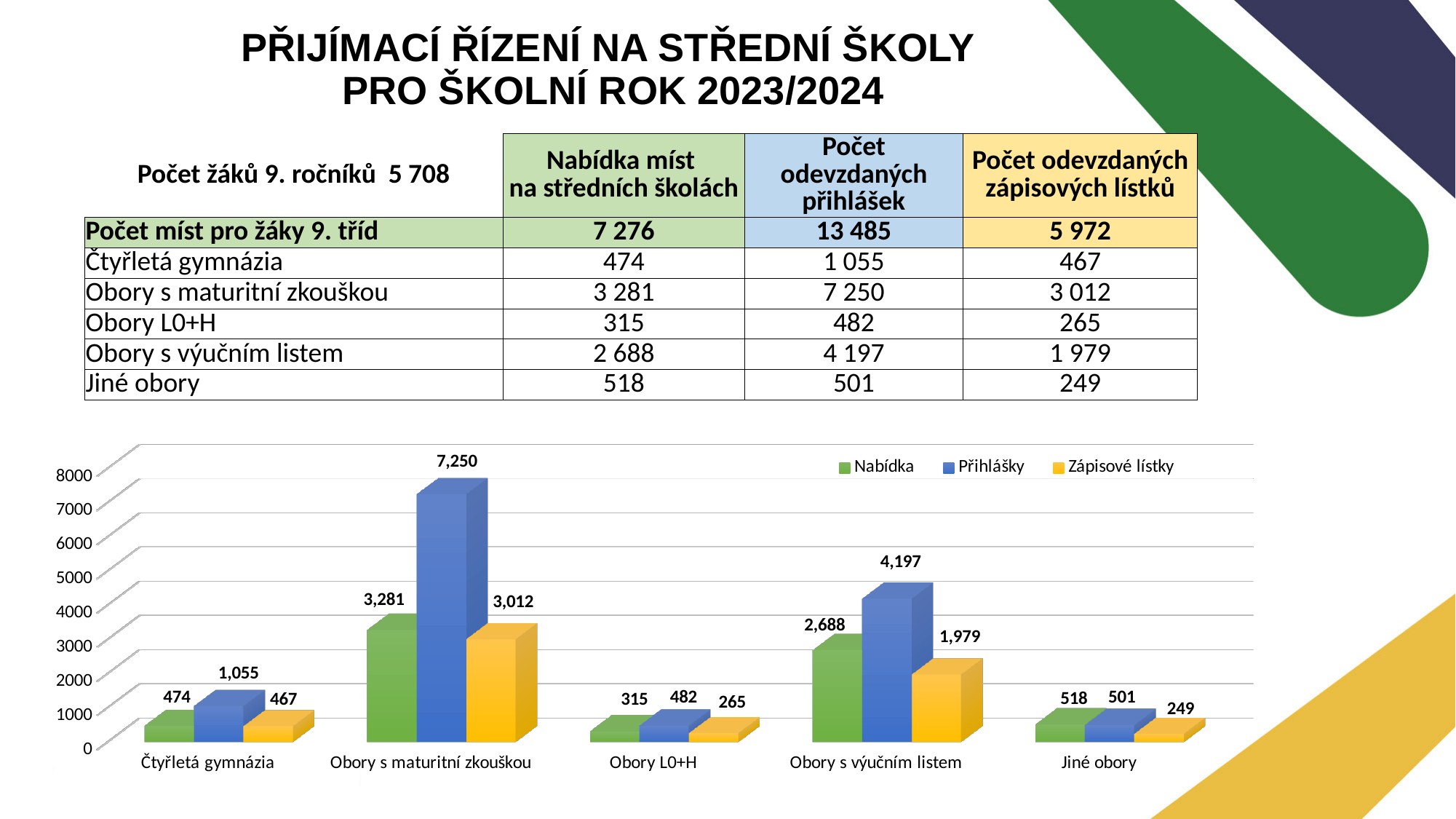
What is the value of Zápisové lístky for Jiné obory in the chart? 249 What is the value of Přihlášky for Obory s maturitní zkouškou in the chart? 7,250 What is the difference between Přihlášky and Nabídka for Čtyřletá gymnázia in the chart? 581 Which is larger for Jiné obory in the chart: Nabídka or Přihlášky? Nabídka Which category has the lowest Zápisové lístky value in the chart? Jiné obory Which category has the highest Přihlášky value in the chart? Obory s maturitní zkouškou What is the value of Nabídka for Obory s výučním listem in the chart? 2,688 Is the Přihlášky value for Obory s výučním listem greater or less than 4000? greater What kind of chart is shown on the slide? bar chart How many series does the chart legend list? 3 Which colour represents Zápisové lístky in the chart? yellow How many categories are shown on the x axis of the chart? 5